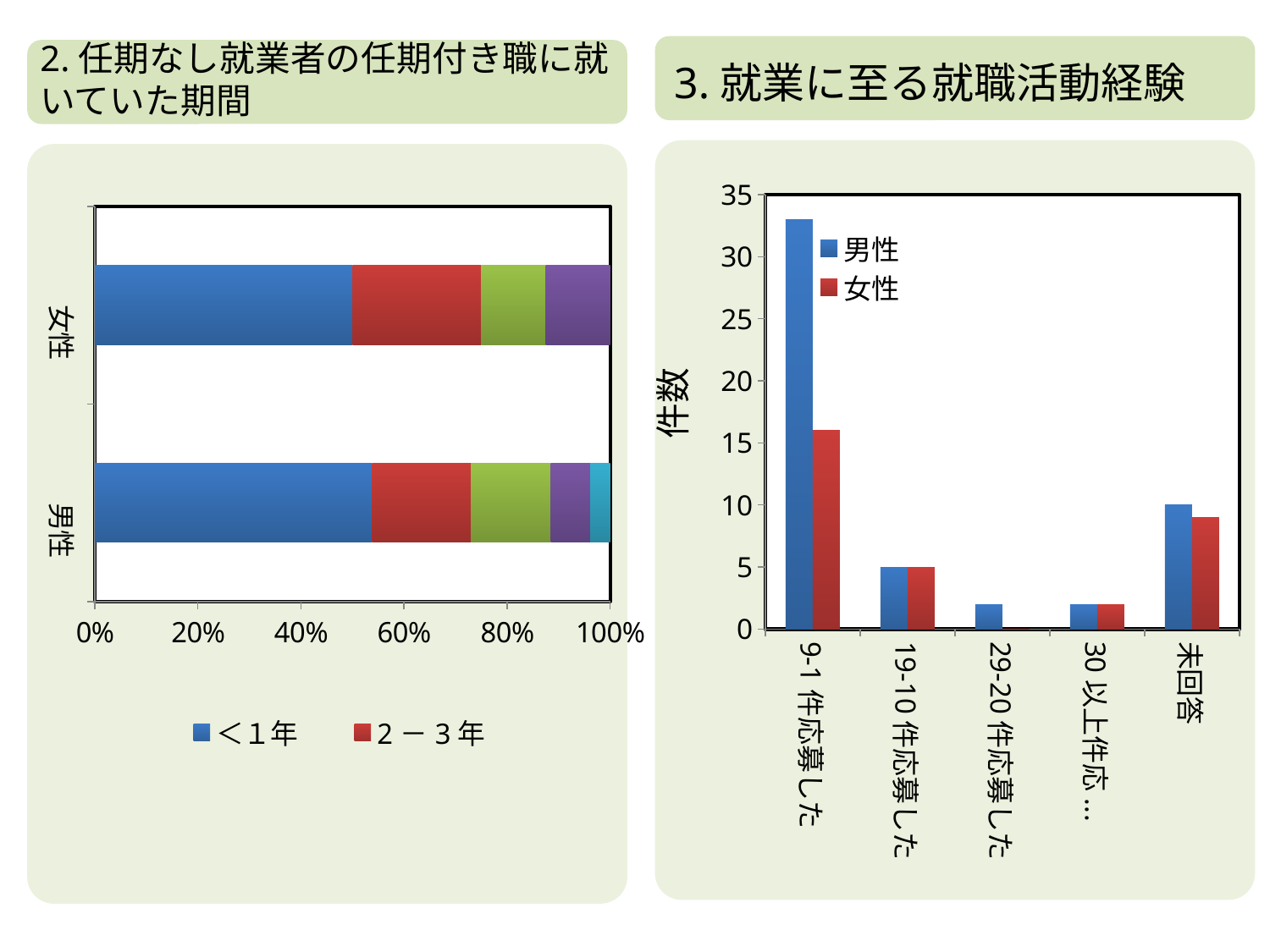
How many categories are shown on the x axis of the chart titled 3. 就業に至る就職活動経験? 5 In the chart titled 3. 就業に至る就職活動経験, what is the 男性 value for 19-10件応募した? 5 In the chart on the left of the slide, is the <1年 share for 女性 greater or less than 60%? less In the chart titled 3. 就業に至る就職活動経験, which series has the larger value for 9-1件応募した, 男性 or 女性? 男性 How many series does the legend list in the chart titled 3. 就業に至る就職活動経験? 2 In the chart titled 3. 就業に至る就職活動経験, what is the 男性 value for 未回答? 10 In the chart titled 3. 就業に至る就職活動経験, which category has the highest 男性 value? 9-1件応募した What kind of chart is the chart titled 3. 就業に至る就職活動経験? bar chart In the chart titled 3. 就業に至る就職活動経験, is the 男性 value for 9-1件応募した greater or less than 30? greater What kind of chart is the chart on the left of the slide (2. 任期なし就業者の任期付き職に就いていた期間)? stacked bar chart In the chart titled 3. 就業に至る就職活動経験, is the 女性 value for 9-1件応募した greater or less than 20? less What is the y-axis label of the chart titled 3. 就業に至る就職活動経験? 件数